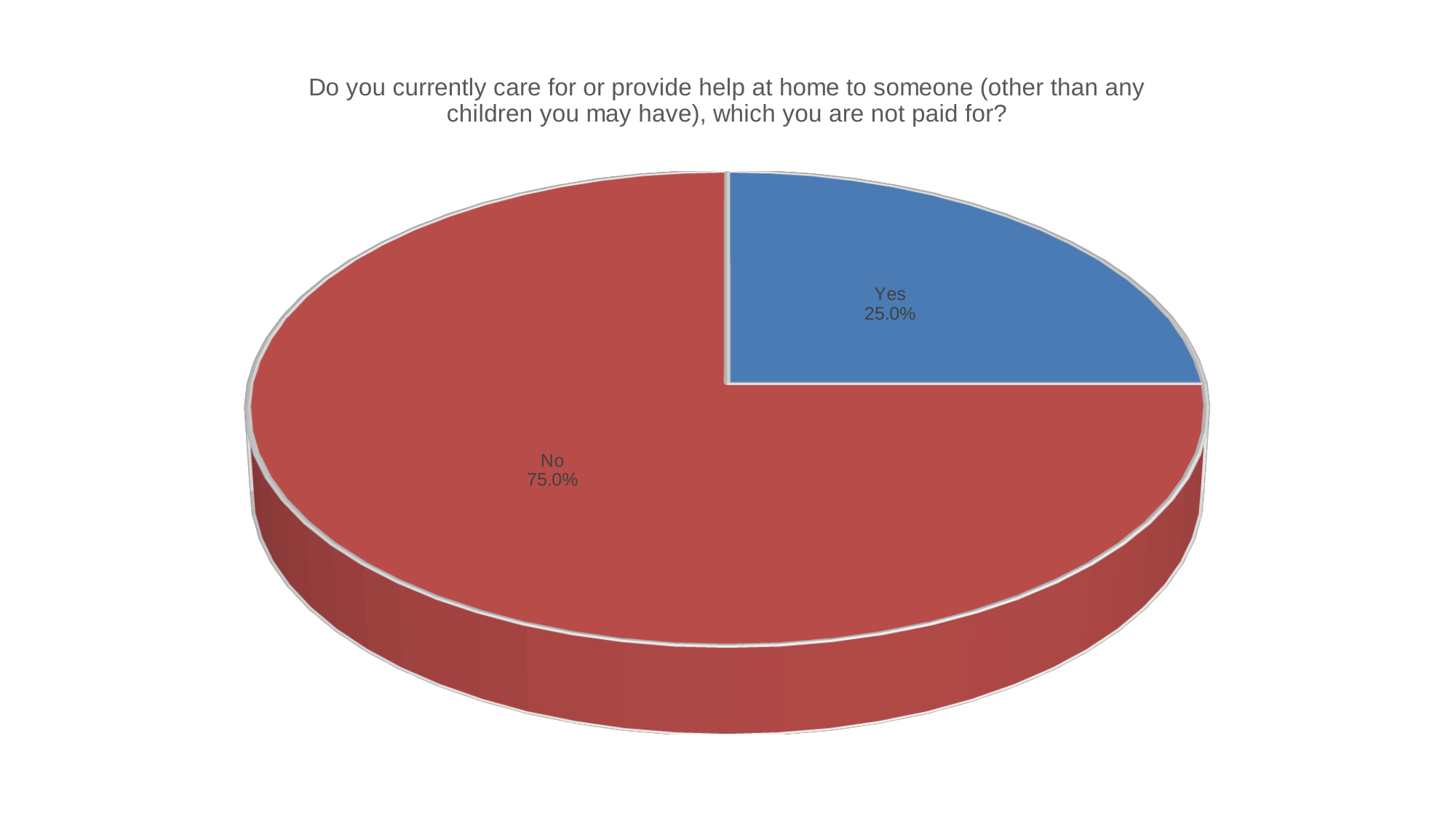
Which response has the largest share of the pie? No How many slices does the pie chart have? 2 What colour is the "Yes" slice? Blue Which response has the smallest share of the pie? Yes What share of the pie does the "No" slice represent? 75.0% What question is shown as the chart title? Do you currently care for or provide help at home to someone (other than any children you may have), which you are not paid for? What kind of chart is shown on the slide? Pie chart What percentage of respondents answered "No"? 75.0% Which slice is larger, "Yes" or "No"? No What percentage of respondents answered "Yes"? 25.0% What is the difference in percentage points between the "No" and "Yes" slices? 50.0%